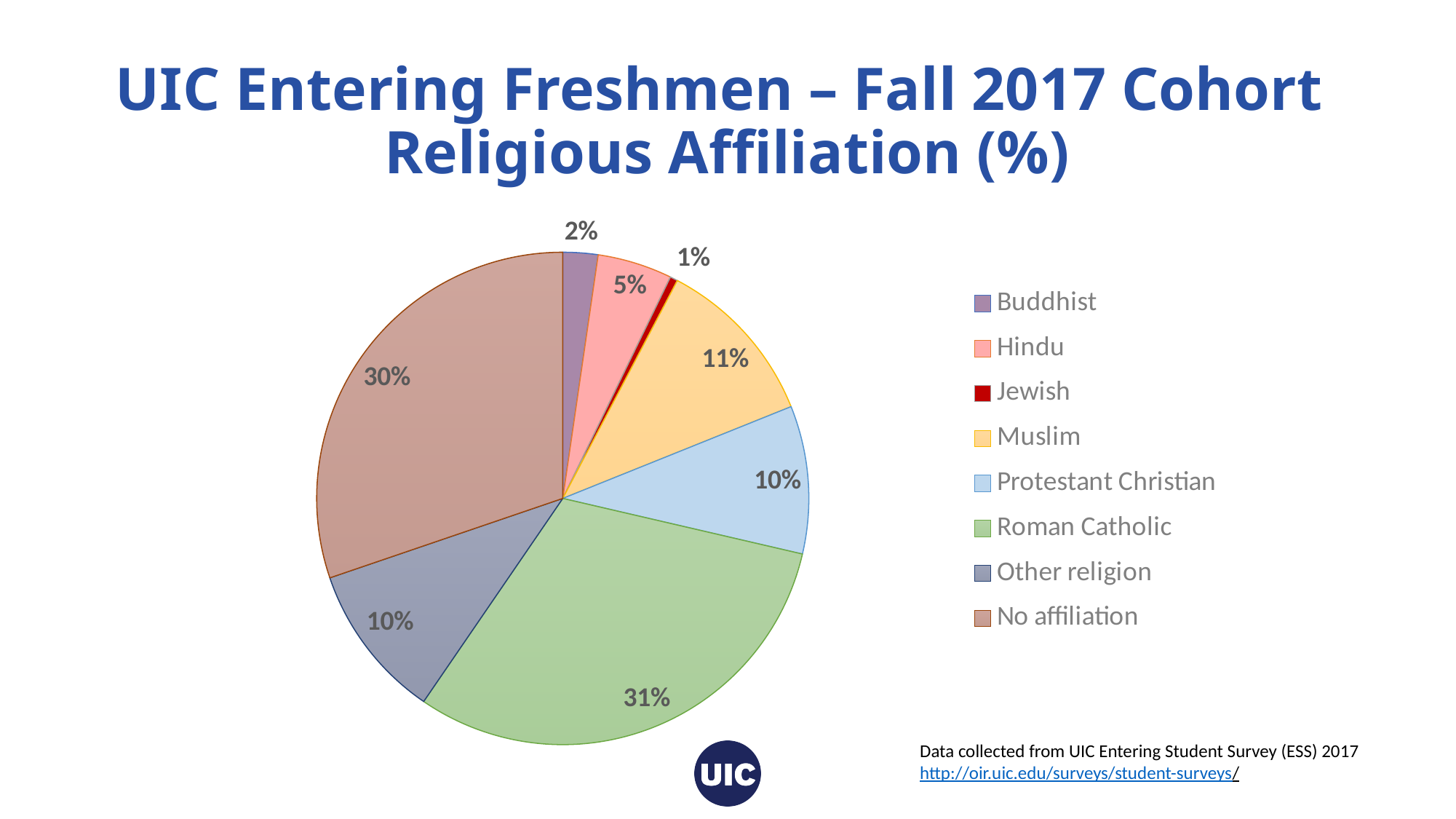
Which is larger, the share for Muslim or the share for Protestant Christian? Muslim What is the difference in percentage points between Muslim and Hindu? 6 Which religious affiliation has the smallest share of the pie chart? Jewish What percentage of the pie chart is Hindu? 5% What percentage of the pie chart is No affiliation? 30% What percentage of the pie chart is Muslim? 11% What percentage of the pie chart is Roman Catholic? 31% What percentage of the pie chart is Buddhist? 2% How many categories does the pie chart show? 8 Which religious affiliation has the largest share of the pie chart? Roman Catholic What colour is the Jewish slice in the pie chart? Red What kind of chart is shown on the slide? Pie chart